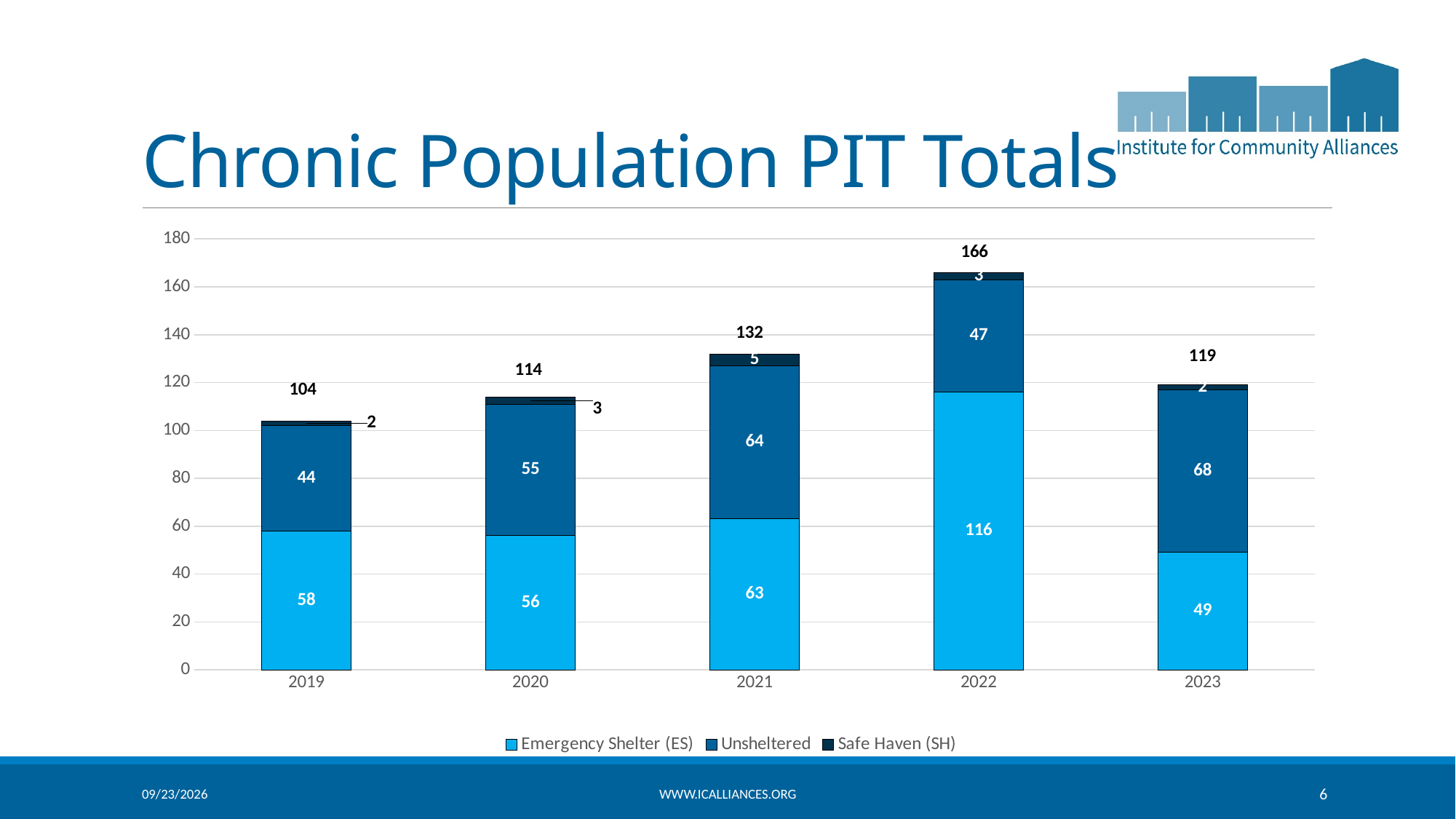
How many years are shown on the x axis? 5 What is the total of the stacked bar for 2021? 132 Which year has the highest stacked bar total? 2022 What is the Safe Haven (SH) value for 2021? 5 Which is larger, the Emergency Shelter (ES) value for 2019 or for 2023? 2019 What kind of chart is shown on the slide? Stacked bar chart What is the difference between the Unsheltered values for 2023 and 2022? 21 What is the Emergency Shelter (ES) value for 2022? 116 Which year has the lowest stacked bar total? 2019 How many series does the legend list? 3 Is the total for 2020 greater or less than 100? greater What is the Unsheltered value for 2023? 68